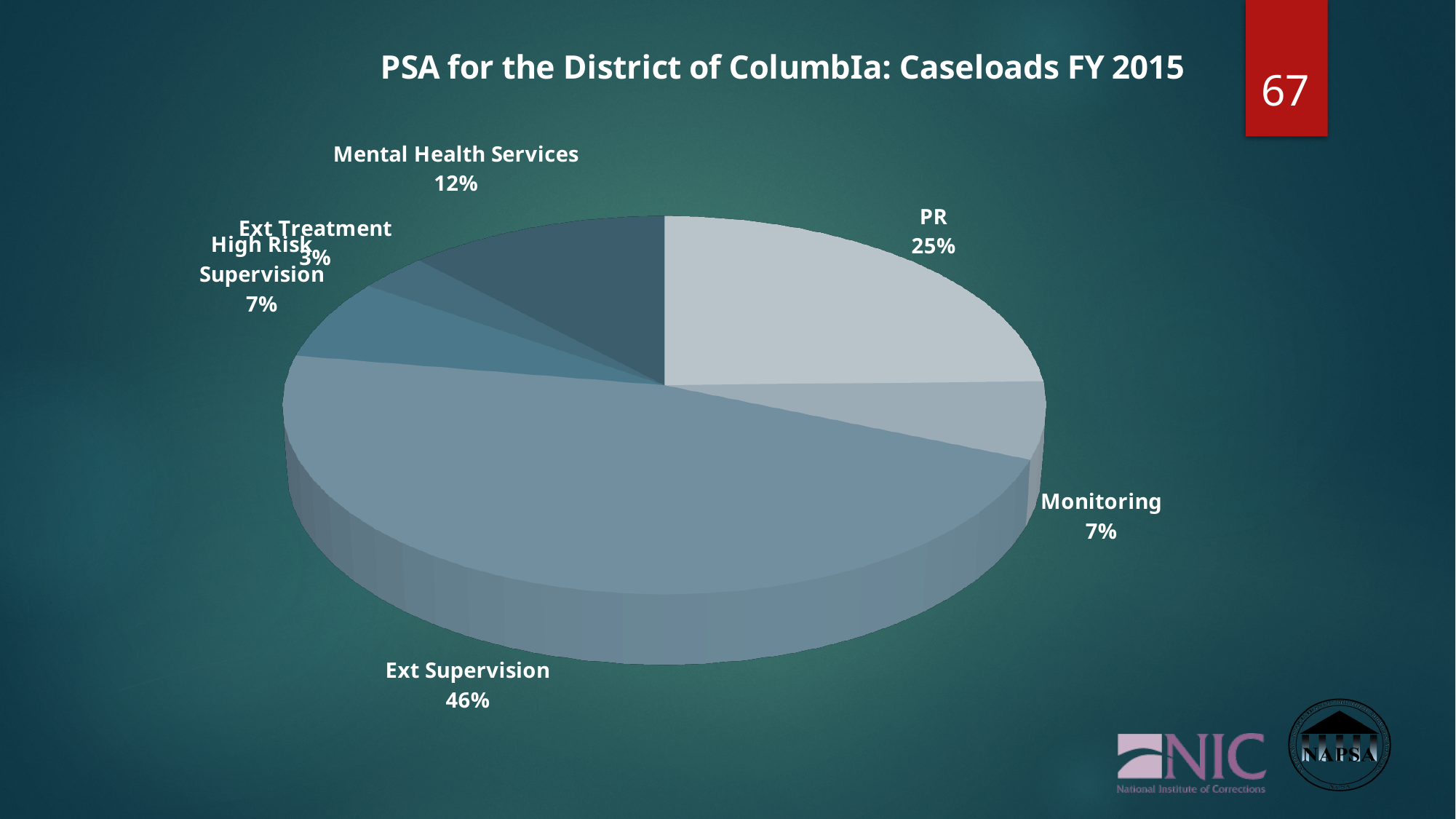
How many categories are shown in the pie chart? 6 Which category has the smallest share of caseloads? Ext Treatment What share of caseloads is Ext Treatment? 3% What share of caseloads is Mental Health Services? 12% Which category has the largest share of caseloads? Ext Supervision What is the title of the chart? PSA for the District of ColumbIa: Caseloads FY 2015 What share of caseloads is Ext Supervision? 46% Which is larger, the share for Mental Health Services or the share for Monitoring? Mental Health Services What kind of chart is shown on the slide? Pie chart What is the difference in percentage points between Mental Health Services and High Risk Supervision? 5 What is the difference in percentage points between Ext Supervision and PR? 21